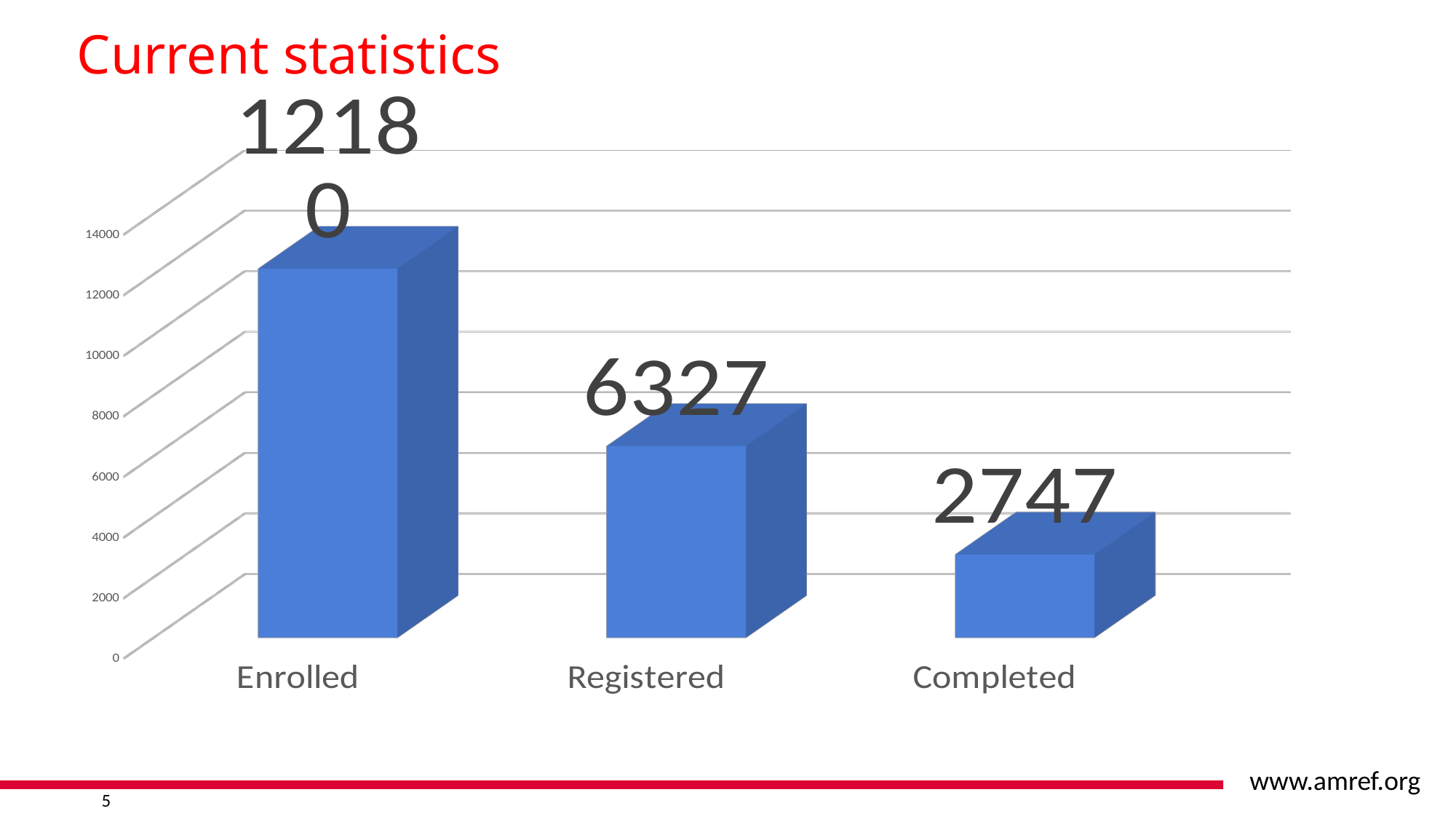
What is the value for Registered? 6327 Which category has the lowest value? Completed What kind of chart is shown on the slide? bar chart What is the value for Enrolled? 12180 What is the value for Completed? 2747 Do the values rise or fall from Enrolled to Completed along the x axis? fall How many categories are shown on the x axis? 3 Which category has the highest value? Enrolled Is the value for Registered greater or less than 8000? less Which is larger, the value for Registered or the value for Completed? Registered What is the difference between the Enrolled and Registered values? 5853 What is the difference between the Registered and Completed values? 3580